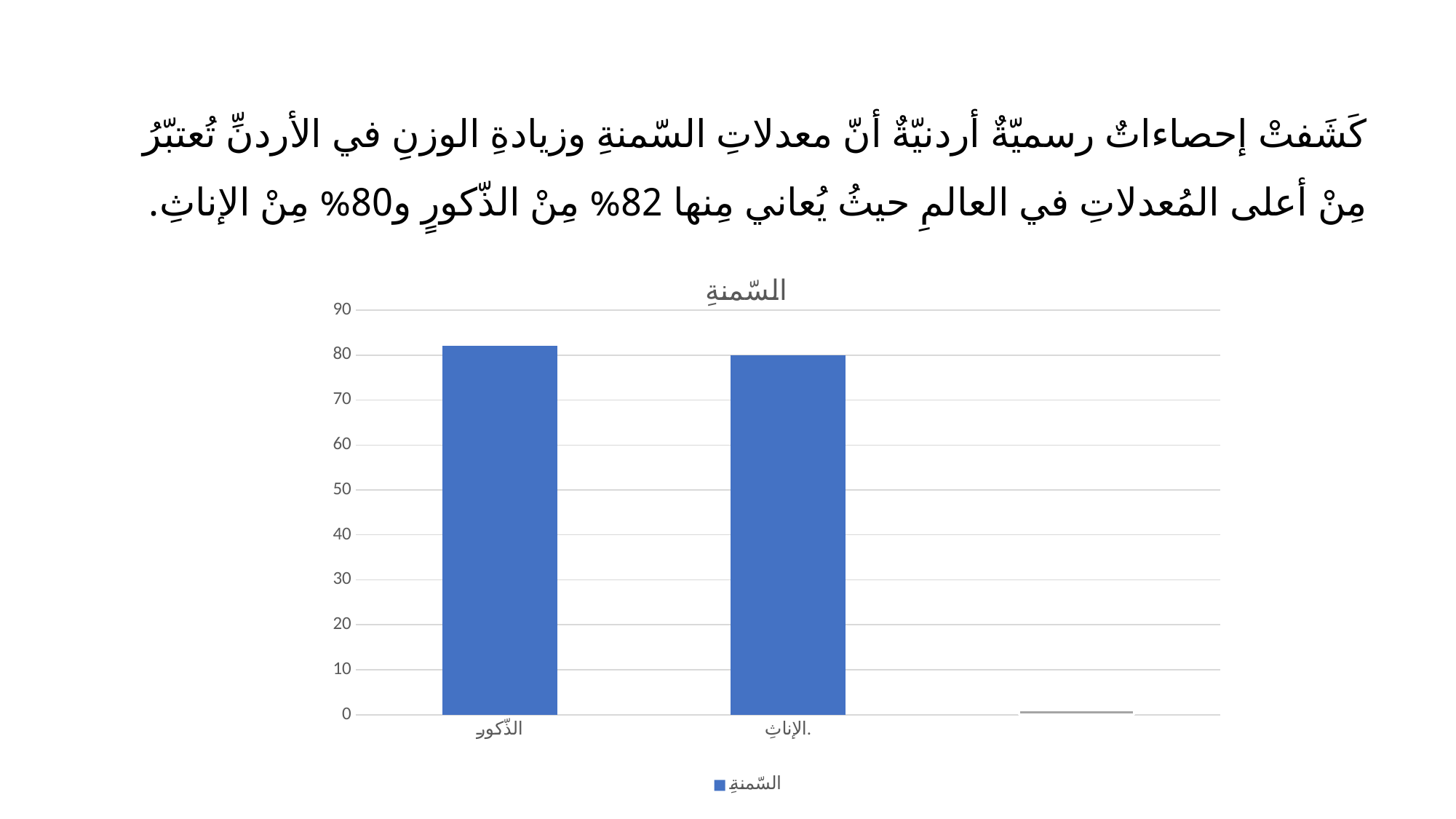
What is the value for الذّكورِ in the chart? 82 Which category has the highest value in the chart? الذّكورِ What kind of chart is shown on the slide? bar chart How many series does the legend list? 1 Is the value for الذّكورِ greater or less than 50? greater Which category has the higher value, الذّكورِ or الإناثِ? الذّكورِ What is the value for الإناثِ in the chart? 80 What colour are the bars in the chart? blue What is the difference between the values for الذّكورِ and الإناثِ? 2 What is the title of the chart? السّمنةِ Is the value for الإناثِ greater or less than 90? less